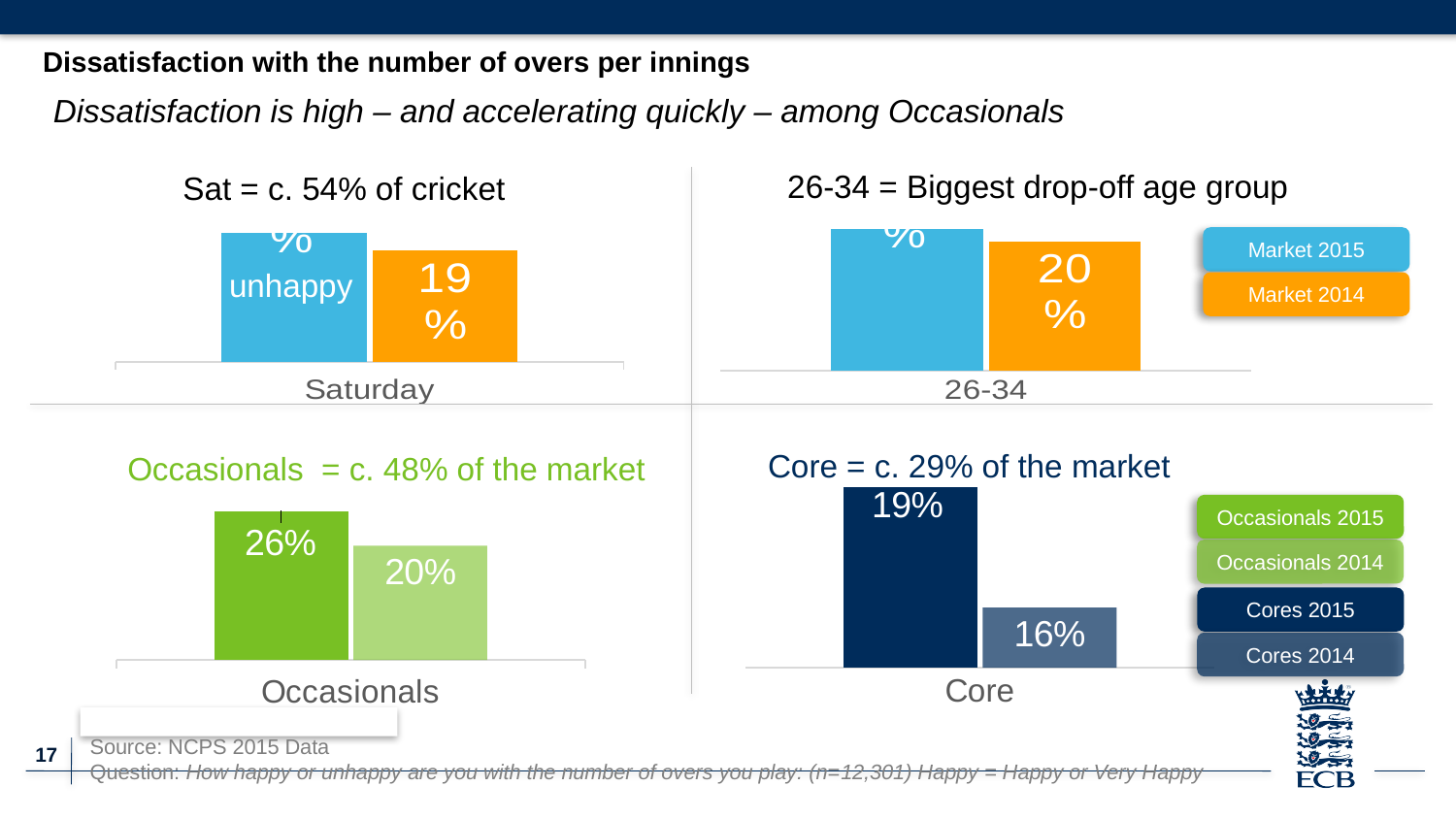
In the 'Occasionals = c. 48% of the market' chart, which is larger, Occasionals 2015 or Occasionals 2014? Occasionals 2015 In the 'Sat = c. 54% of cricket' chart, what is the value of the orange Market 2014 bar for Saturday? 19% In the '26-34 = Biggest drop-off age group' chart, what is the value of the orange Market 2014 bar? 20% In the 'Core = c. 29% of the market' chart, what is the value for Cores 2015? 19% In the 'Occasionals = c. 48% of the market' chart, what is the value for Occasionals 2015? 26% In the 'Occasionals = c. 48% of the market' chart, what is the value for Occasionals 2014? 20% In the 'Occasionals = c. 48% of the market' chart, what is the difference between the Occasionals 2015 and Occasionals 2014 values? 6% In the 'Core = c. 29% of the market' chart, which is larger, Cores 2015 or Cores 2014? Cores 2015 What kind of chart is the 'Core = c. 29% of the market' chart? Bar chart In the 'Core = c. 29% of the market' chart, what is the value for Cores 2014? 16% In the 'Core = c. 29% of the market' chart, what is the difference between the Cores 2015 and Cores 2014 values? 3% How many entries does the legend next to the 'Core = c. 29% of the market' chart list? 4